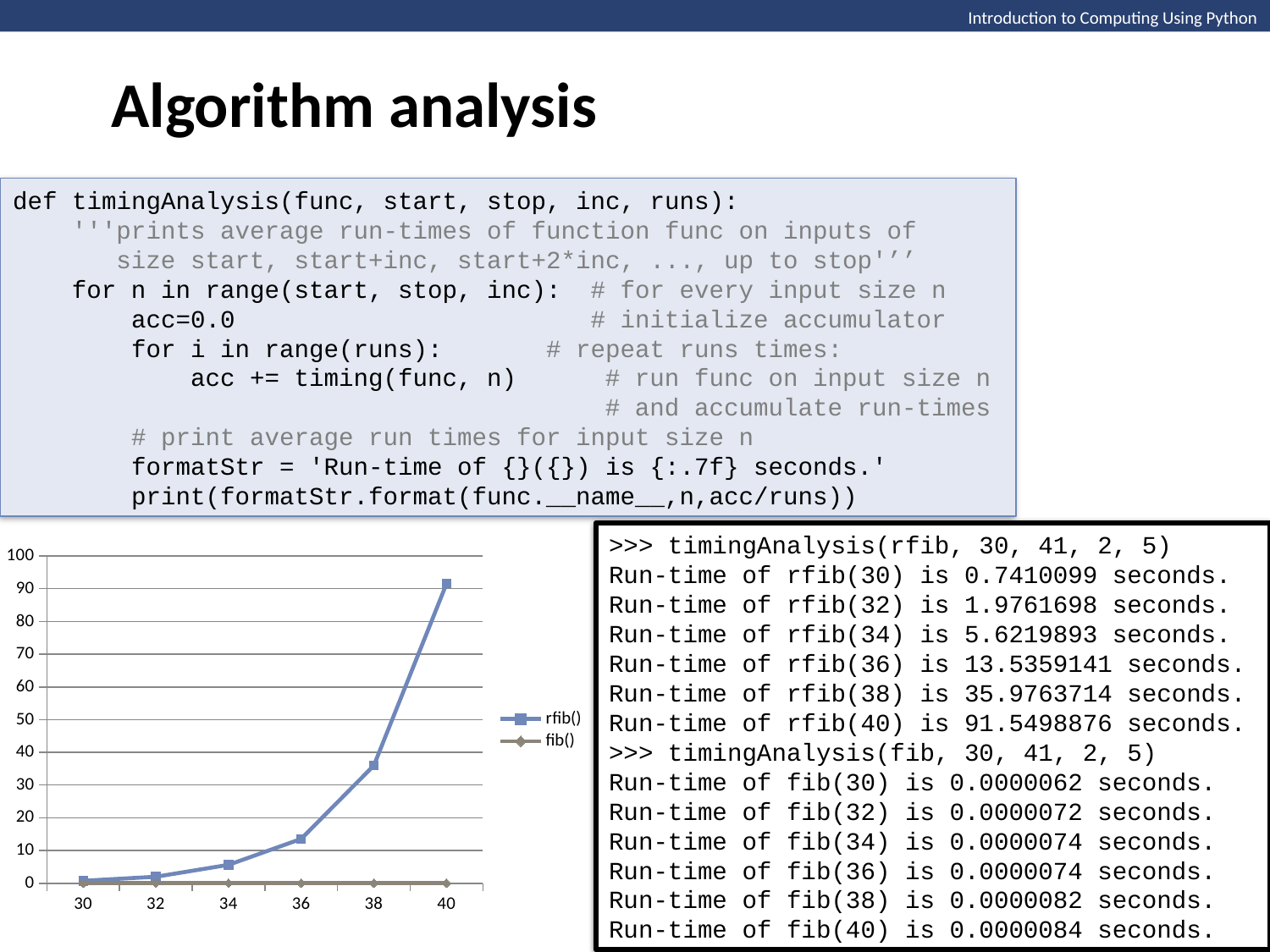
Is the value of rfib() at input size 36 greater or less than 20? less How many x-axis categories (input sizes) are plotted on the chart? 6 At which input size does the rfib() series reach its highest value? 40 Is the value of rfib() at input size 30 greater or less than 10? less Is the value of rfib() at input size 40 greater or less than 80? greater Does the rfib() series rise or fall as the input size increases from 30 to 40? rises What are the two series named in the chart's legend? rfib() and fib() What kind of chart is shown on the slide? line chart What is the highest value shown on the chart's y axis? 100 How many series does the chart's legend list? 2 At input size 40, which series has the larger value, rfib() or fib()? rfib()